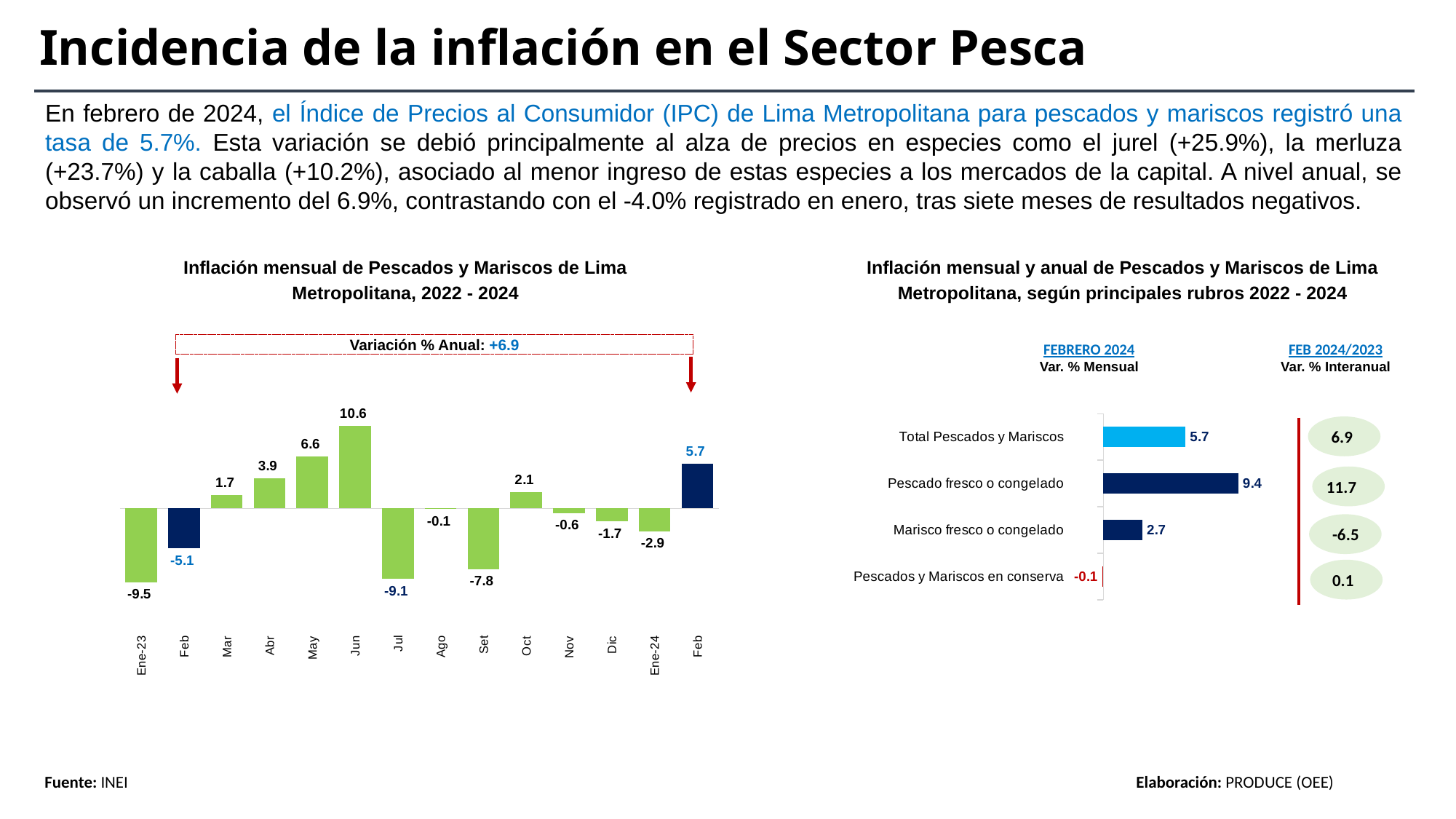
In the left chart 'Inflación mensual de Pescados y Mariscos de Lima Metropolitana, 2022 - 2024', how many months are plotted? 14 In the left chart 'Inflación mensual de Pescados y Mariscos de Lima Metropolitana, 2022 - 2024', which is larger, the value for Feb (2024) or the value for Oct? Feb (2024) In the right chart 'Inflación mensual y anual de Pescados y Mariscos de Lima Metropolitana, según principales rubros 2022 - 2024', what is the Var. % Mensual for Pescado fresco o congelado? 9.4 In the left chart 'Inflación mensual de Pescados y Mariscos de Lima Metropolitana, 2022 - 2024', which month has the lowest value? Ene-23 In the right chart 'Inflación mensual y anual de Pescados y Mariscos de Lima Metropolitana, según principales rubros 2022 - 2024', which category has the highest Var. % Mensual? Pescado fresco o congelado In the left chart 'Inflación mensual de Pescados y Mariscos de Lima Metropolitana, 2022 - 2024', what is the value for Ene-24? -2.9 In the left chart 'Inflación mensual de Pescados y Mariscos de Lima Metropolitana, 2022 - 2024', what is the value for Jun? 10.6 In the left chart 'Inflación mensual de Pescados y Mariscos de Lima Metropolitana, 2022 - 2024', which month has the highest value? Jun In the left chart 'Inflación mensual de Pescados y Mariscos de Lima Metropolitana, 2022 - 2024', what annual variation is shown in the box above the bars? +6.9 What kind of chart is the right chart 'Inflación mensual y anual de Pescados y Mariscos de Lima Metropolitana, según principales rubros 2022 - 2024'? Bar chart In the left chart 'Inflación mensual de Pescados y Mariscos de Lima Metropolitana, 2022 - 2024', what is the difference between the values for Jun and May? 4.0 In the right chart 'Inflación mensual y anual de Pescados y Mariscos de Lima Metropolitana, según principales rubros 2022 - 2024', what is the Var. % Interanual for Marisco fresco o congelado? -6.5